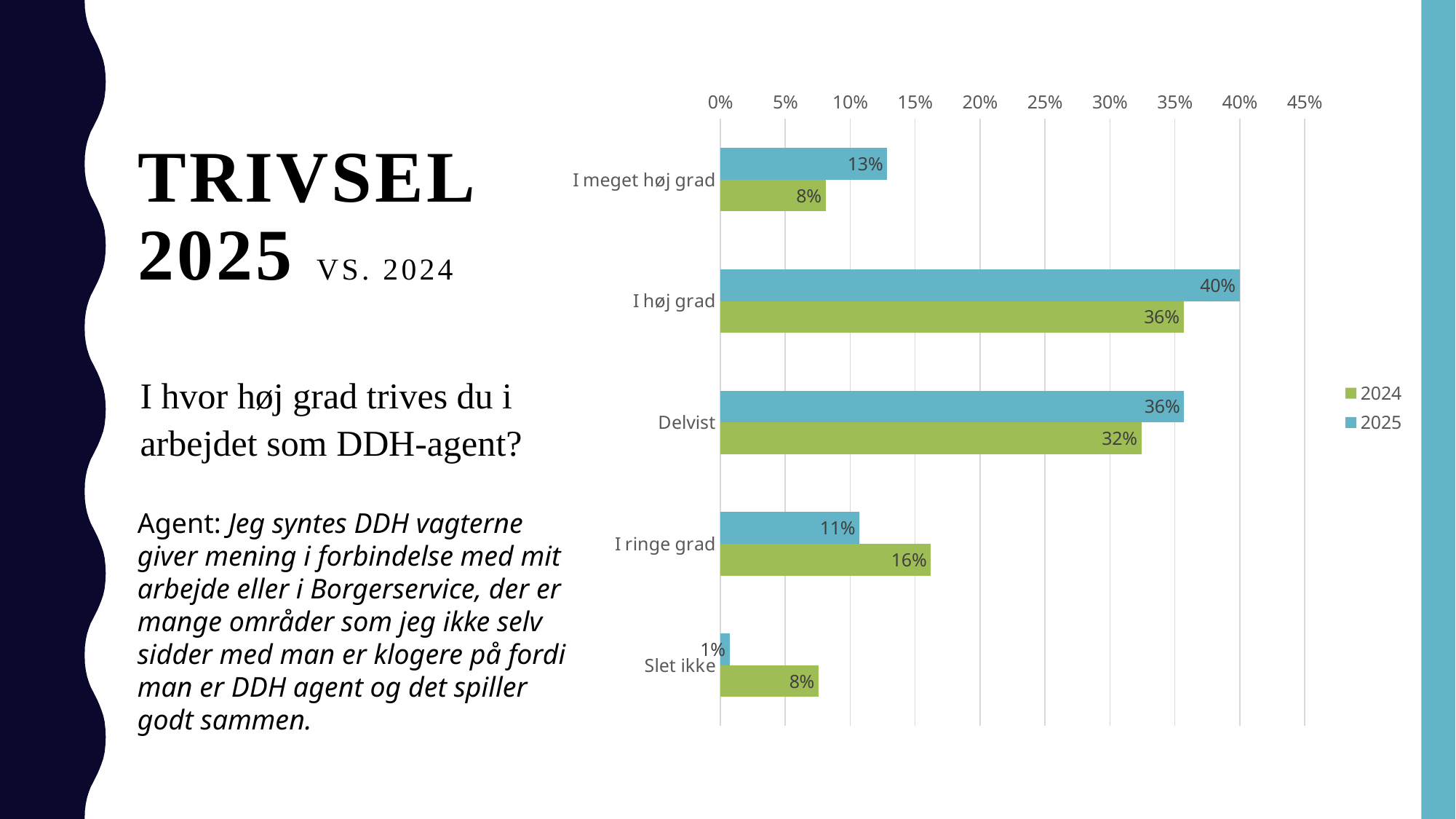
What is the 2024 value for "Delvist"? 32% What is the 2025 value for "I høj grad"? 40% Which category has the highest 2025 value? I høj grad What kind of chart is shown on the slide? Bar chart How many series does the legend list? 2 Which colour represents the 2025 series in the chart? Blue What is the 2024 value for "I ringe grad"? 16% What is the 2025 value for "Slet ikke"? 1% Which is larger for "I ringe grad": the 2024 value or the 2025 value? 2024 Which category has the lowest 2024 value? I meget høj grad and Slet ikke (both 8%) What is the difference between the 2025 and 2024 values for "I meget høj grad"? 5% How many categories are shown on the chart? 5